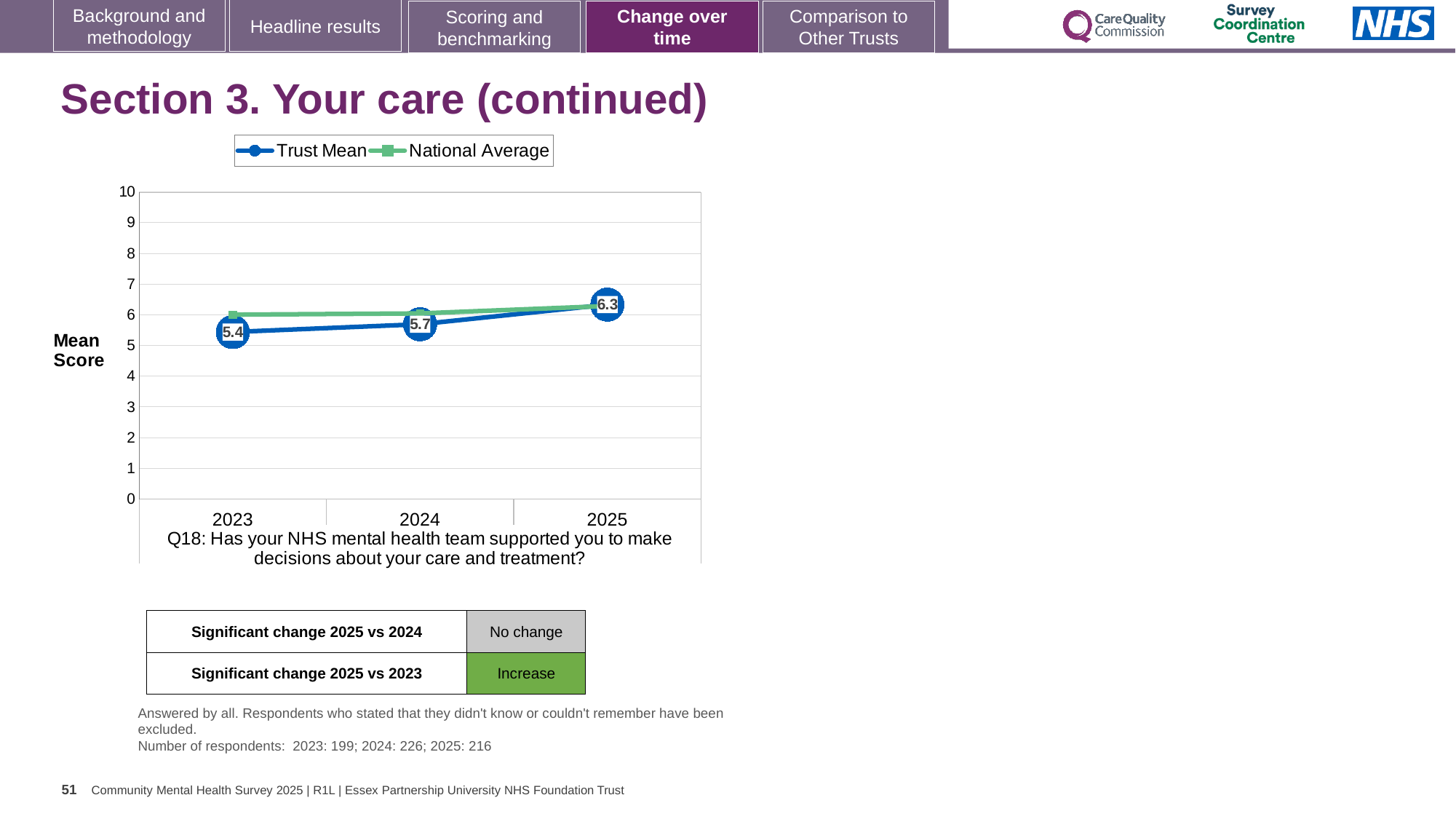
What kind of chart is shown on the slide? Line chart What is the Trust Mean score for 2023? 5.4 In 2023, which series has the higher value, Trust Mean or National Average? National Average What is the difference between the Trust Mean score in 2025 and in 2023? 0.9 How many years are shown on the x axis of the chart? 3 What is the Trust Mean score for 2025? 6.3 What is the Trust Mean score for 2024? 5.7 Is the National Average value for 2023 greater or less than 5? greater In which year is the Trust Mean score lowest? 2023 Which is larger, the Trust Mean score in 2024 or in 2025? 2025 In which year is the Trust Mean score highest? 2025 How many series does the chart legend list? 2